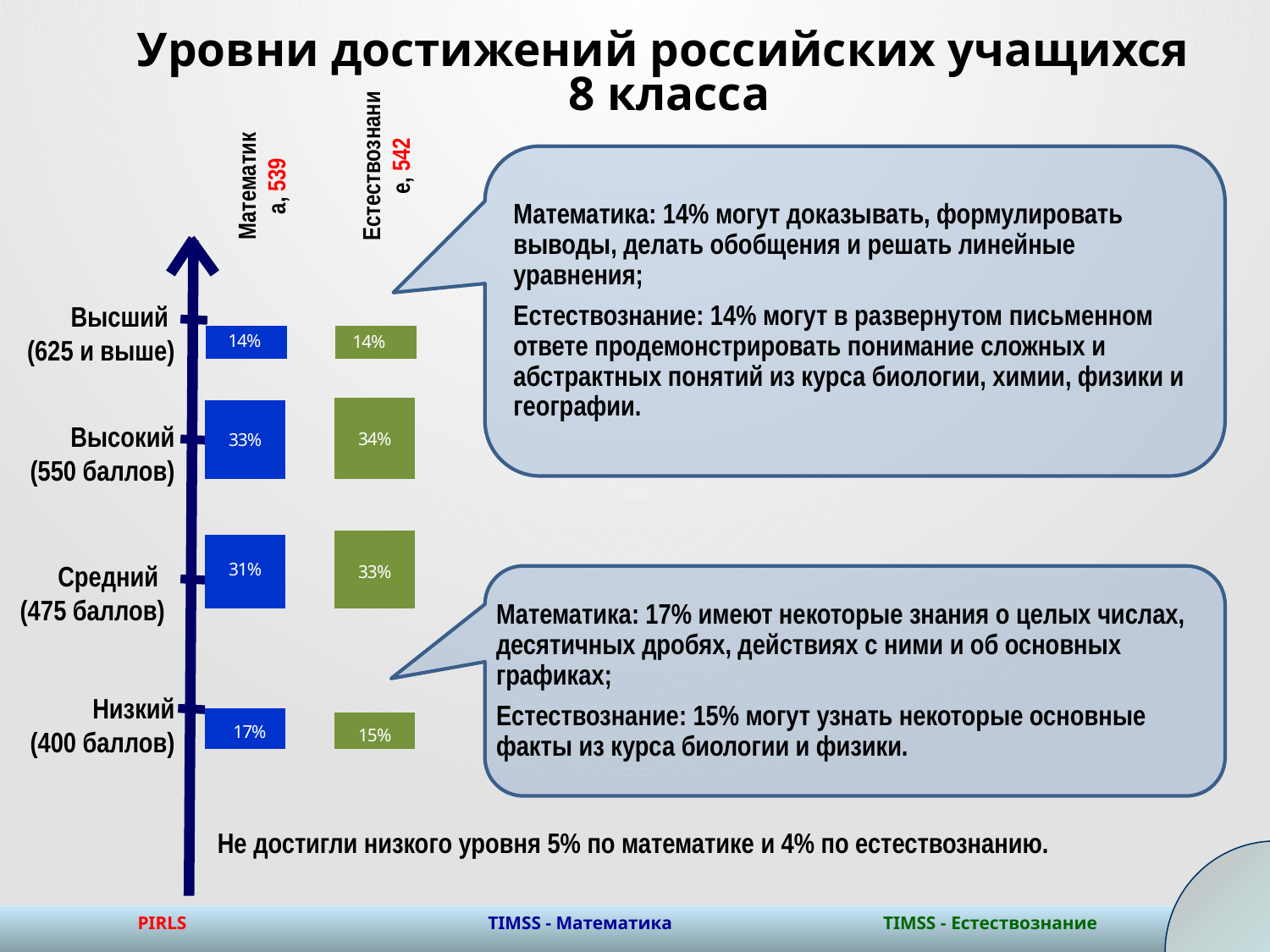
What colour are the bars for Естествознание? Green Which achievement level has the highest percentage of students in Математика? Высокий (550 баллов) Which achievement level has the lowest percentage of students in Естествознание? Высший (625 и выше) What percentage of students reached the Высший (625 и выше) level in Математика? 14% At the Низкий (400 баллов) level, which subject has the larger percentage, Математика or Естествознание? Математика What percentage of students reached the Высокий (550 баллов) level in Естествознание? 34% How many achievement levels are shown on the chart? 4 How many subjects (series) are plotted on the chart? 2 What average score is shown for Математика at the top of the chart? 539 What percentage of students are at the Средний (475 баллов) level in Математика? 31% What is the difference between the Средний level percentages for Естествознание and Математика? 2% What percentage of students are at the Низкий (400 баллов) level in Естествознание? 15%